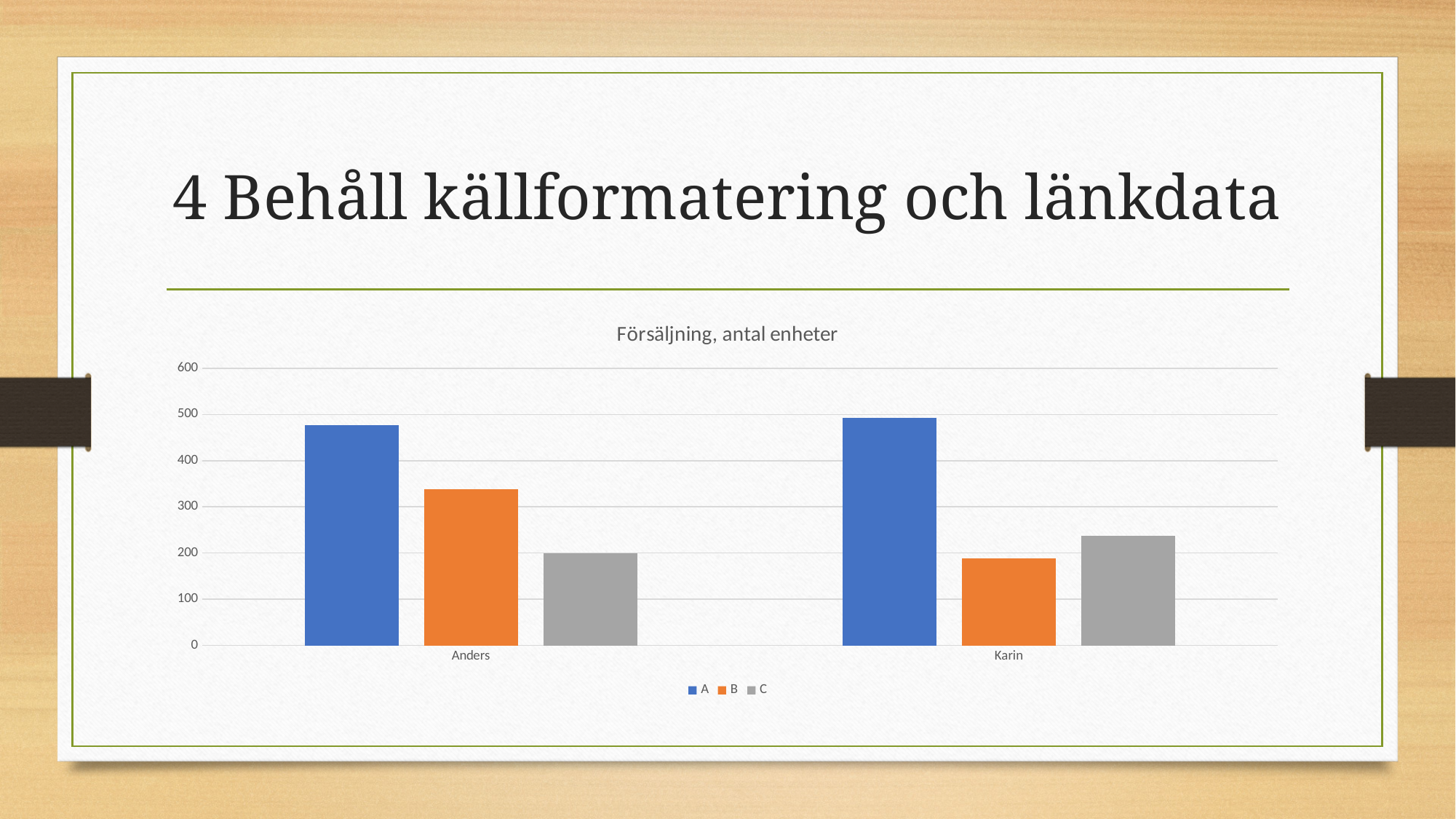
Is the value of series C for Karin greater or less than 300? less Which is larger: series B for Karin or series C for Karin? C Which series has the lowest value for Anders? C Which series has the lowest value for Karin? B How many categories are shown on the x axis? 2 Is the value of series B for Anders greater or less than 300? greater Which is larger: series B for Anders or series B for Karin? Anders What is the title of the chart? Försäljning, antal enheter Is the value of series A for Anders greater or less than 400? greater Which series has the highest value for Anders? A What kind of chart is shown on the slide? bar chart How many series does the legend list? 3